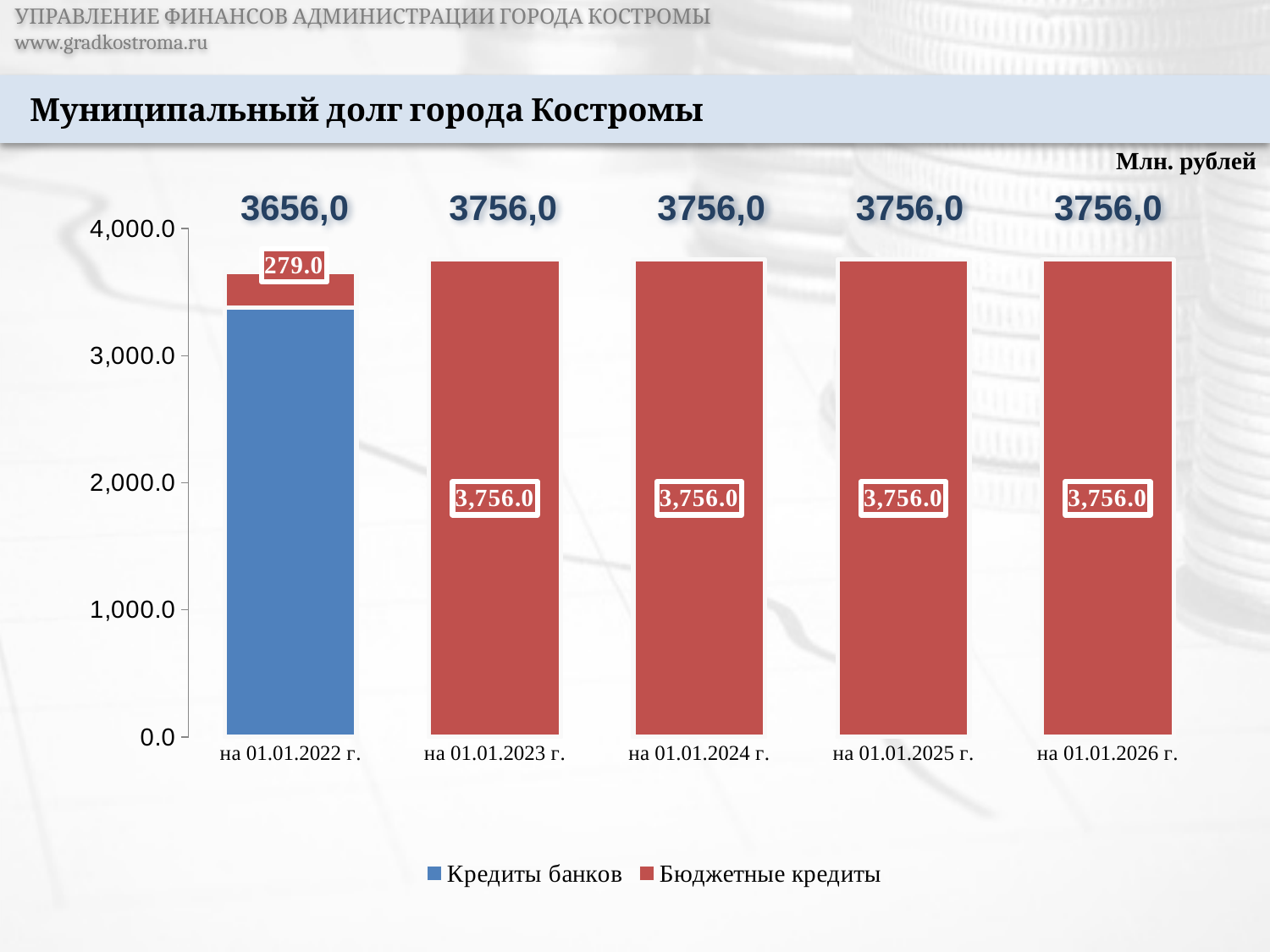
What is the total municipal debt shown above the bar for на 01.01.2022 г.? 3656,0 Which date has the lowest total municipal debt? на 01.01.2022 г. What is the difference between the totals for на 01.01.2023 г. and на 01.01.2022 г.? 100,0 How many series does the legend list? 2 What unit of measurement is stated for the chart? Млн. рублей Which is larger: Бюджетные кредиты for на 01.01.2022 г. or for на 01.01.2023 г.? на 01.01.2023 г. How many dates (categories) are shown on the x axis? 5 What kind of chart is shown on the slide? stacked bar chart What is the total shown above the bar for на 01.01.2025 г.? 3756,0 Is the value of Кредиты банков for на 01.01.2022 г. greater or less than 3,000.0? greater What is the value of Бюджетные кредиты for на 01.01.2024 г.? 3,756.0 What is the value of Бюджетные кредиты for на 01.01.2022 г.? 279.0